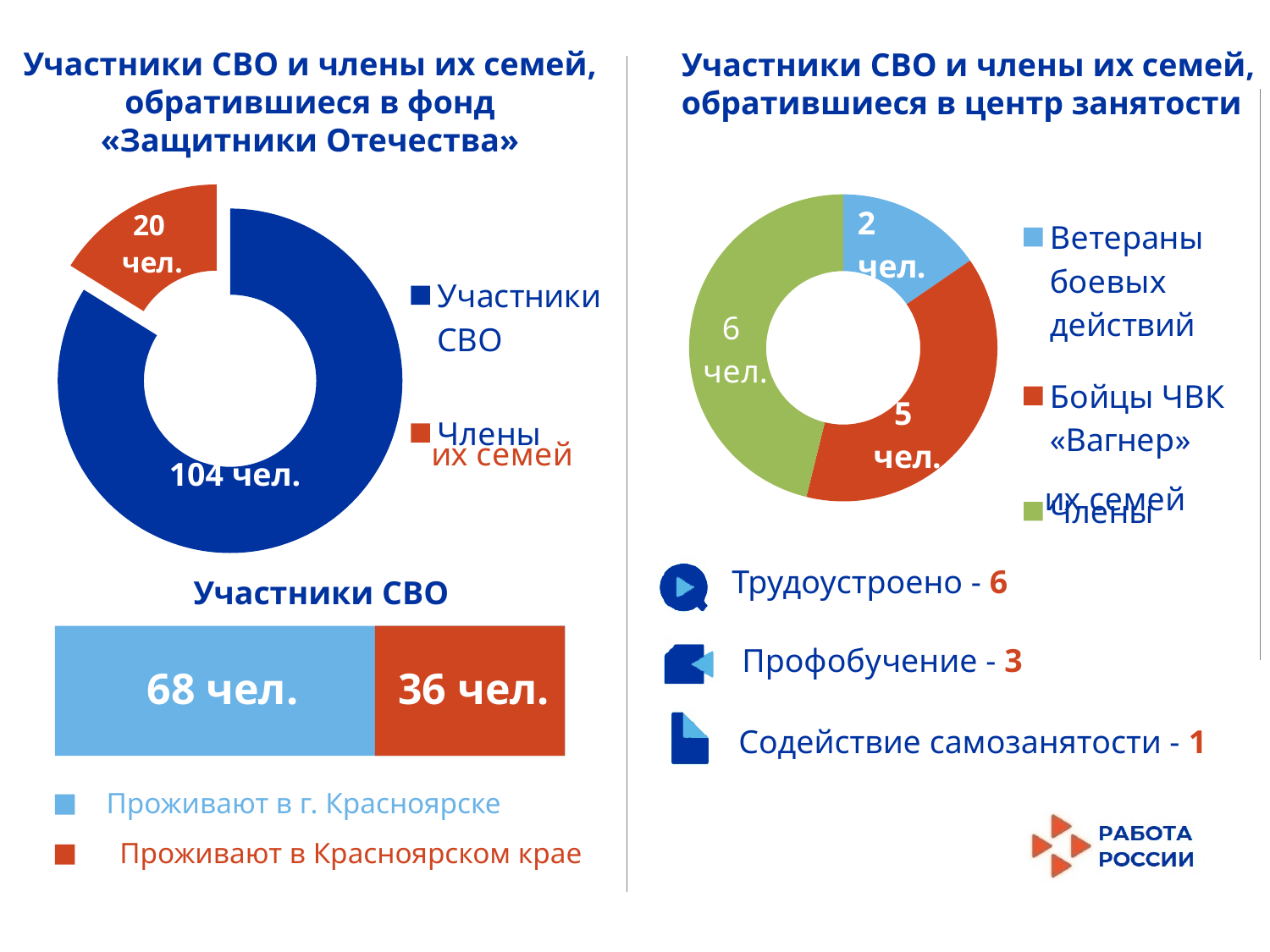
In the stacked bar chart titled «Участники СВО» at the bottom left, what is the total of the bar? 104 чел. In the chart titled «Участники СВО и члены их семей, обратившиеся в центр занятости», what is the value for Ветераны боевых действий? 2 чел. In the chart titled «Участники СВО и члены их семей, обратившиеся в фонд «Защитники Отечества»», what is the value for Члены их семей? 20 чел. In the chart titled «Участники СВО и члены их семей, обратившиеся в фонд «Защитники Отечества»», what is the value for Участники СВО? 104 чел. In the chart titled «Участники СВО и члены их семей, обратившиеся в фонд «Защитники Отечества»», what is the difference between Участники СВО and Члены их семей? 84 чел. In the stacked bar chart titled «Участники СВО» at the bottom left, which is larger: Проживают в г. Красноярске or Проживают в Красноярском крае? Проживают в г. Красноярске In the stacked bar chart titled «Участники СВО» at the bottom left, what is the value for Проживают в г. Красноярске? 68 чел. What kind of chart is the one titled «Участники СВО и члены их семей, обратившиеся в фонд «Защитники Отечества»»? Donut (pie) chart In the chart titled «Участники СВО и члены их семей, обратившиеся в центр занятости», which category has the lowest value? Ветераны боевых действий In the chart titled «Участники СВО и члены их семей, обратившиеся в центр занятости», what is the value for Бойцы ЧВК «Вагнер»? 5 чел. How many categories does the legend list in the chart titled «Участники СВО и члены их семей, обратившиеся в центр занятости»? 3 In the chart titled «Участники СВО и члены их семей, обратившиеся в центр занятости», which category has the highest value? Члены их семей